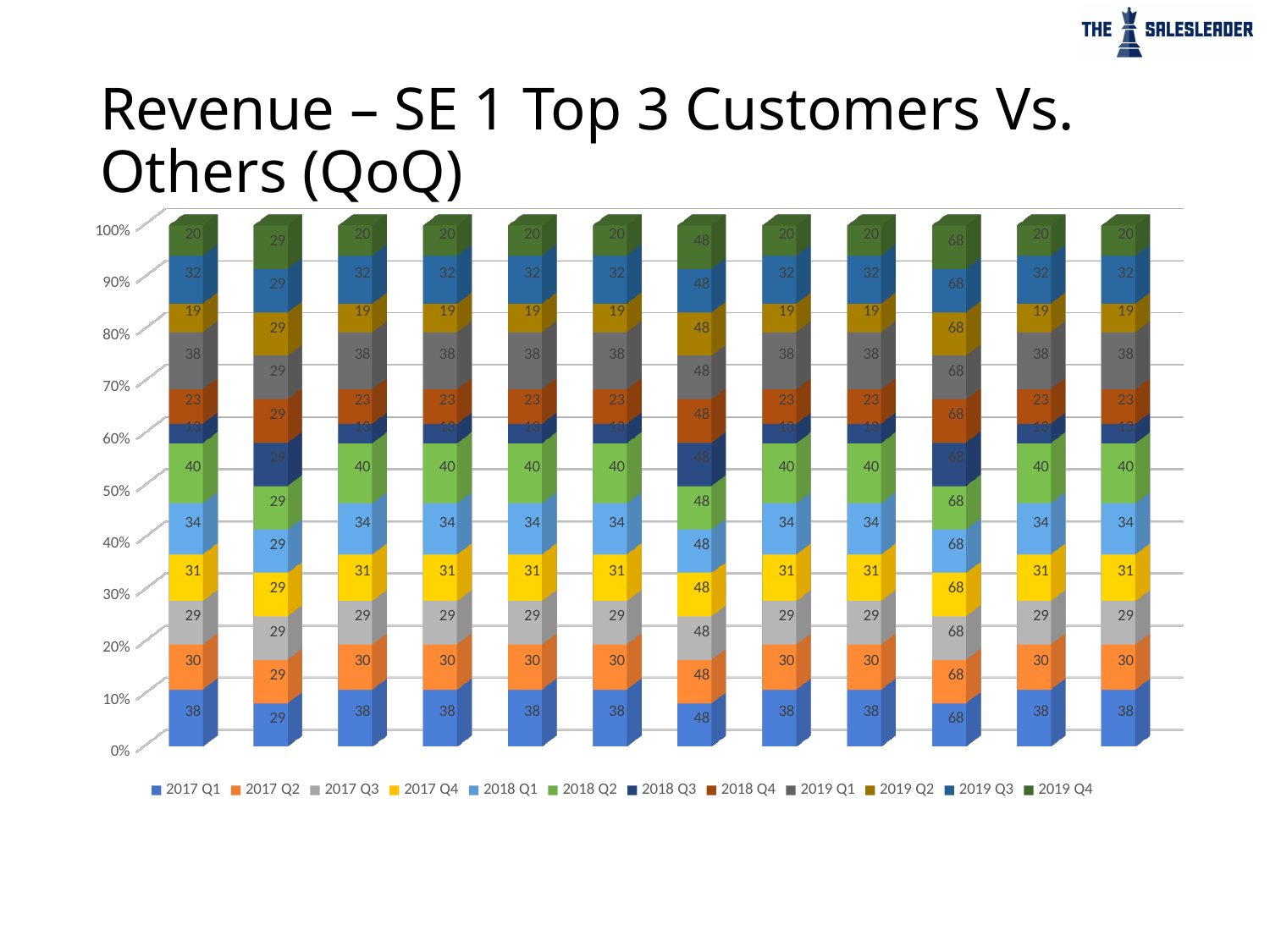
In the leftmost bar, what is the value of the 2018 Q2 segment? 40 What value is shown on every segment of the seventh bar from the left? 48 In the leftmost bar, what is the difference between the 2017 Q1 segment and the 2017 Q2 segment? 8 What value is shown on every segment of the second bar from the left? 29 In the leftmost bar, what is the value of the 2017 Q1 segment? 38 In the leftmost bar, which series has the smallest segment value? 2018 Q3 How many stacked bars are plotted in the chart? 12 How many series does the legend list? 12 What kind of chart is shown on the slide? Stacked bar chart What value is shown on every segment of the tenth bar from the left? 68 In the leftmost bar, which series has the largest segment value? 2018 Q2 What is the title of the chart slide? Revenue – SE 1 Top 3 Customers Vs. Others (QoQ)